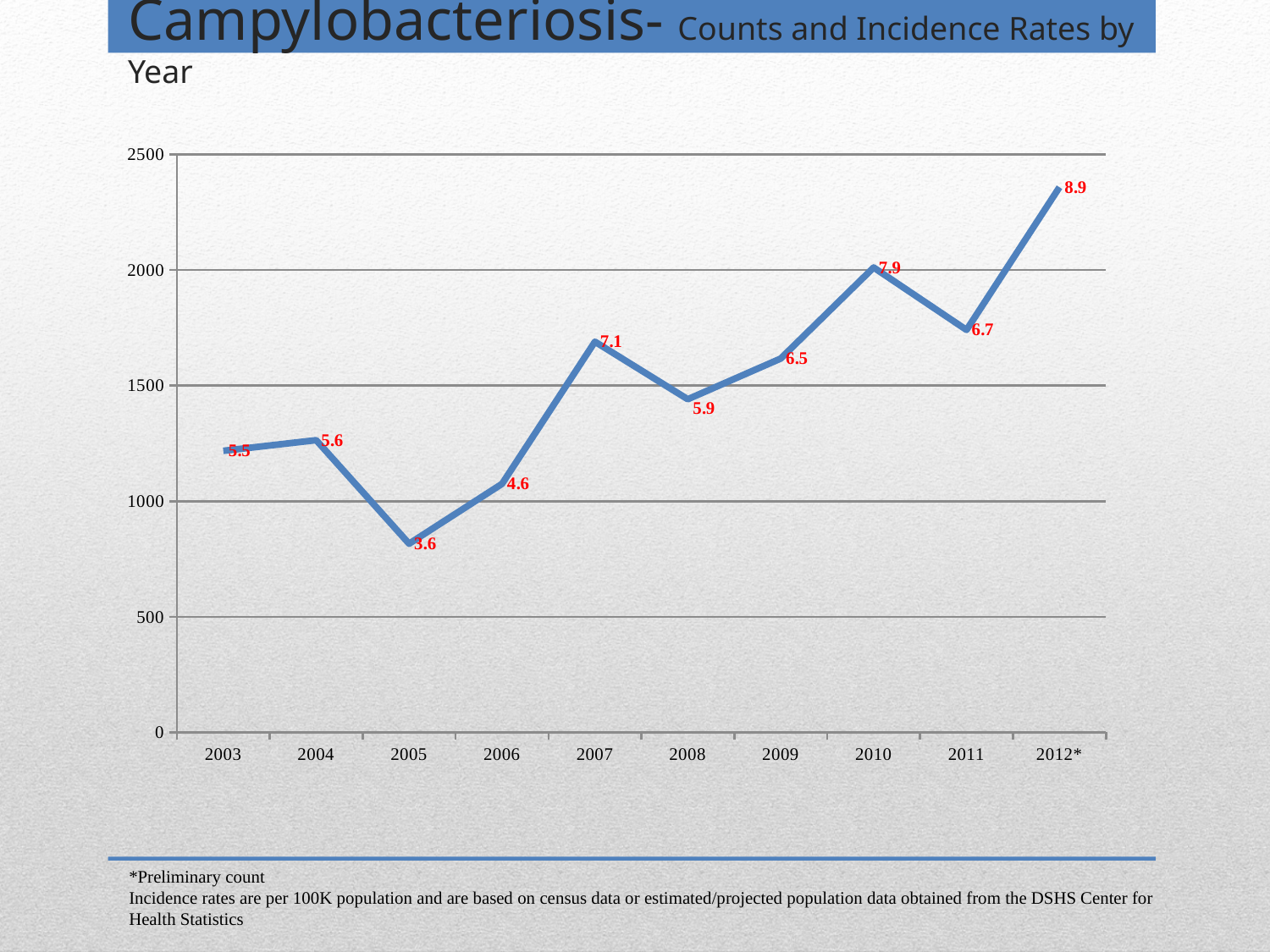
Which year has the lowest count on the line? 2005 What kind of chart is shown on the slide? line chart Which year has the higher count, 2007 or 2008? 2007 What incidence rate is labelled at the 2012* point? 8.9 What incidence rate is labelled at the 2010 point? 7.9 Which year has the highest count on the line? 2012* What is the difference between the incidence rate labelled for 2012* and the one labelled for 2005? 5.3 Is the count for 2012* greater or less than 2000? greater What incidence rate is labelled at the 2008 point? 5.9 Is the count for 2005 greater or less than 1000? less What incidence rate is labelled at the 2005 point? 3.6 How many years are plotted along the x axis? 10